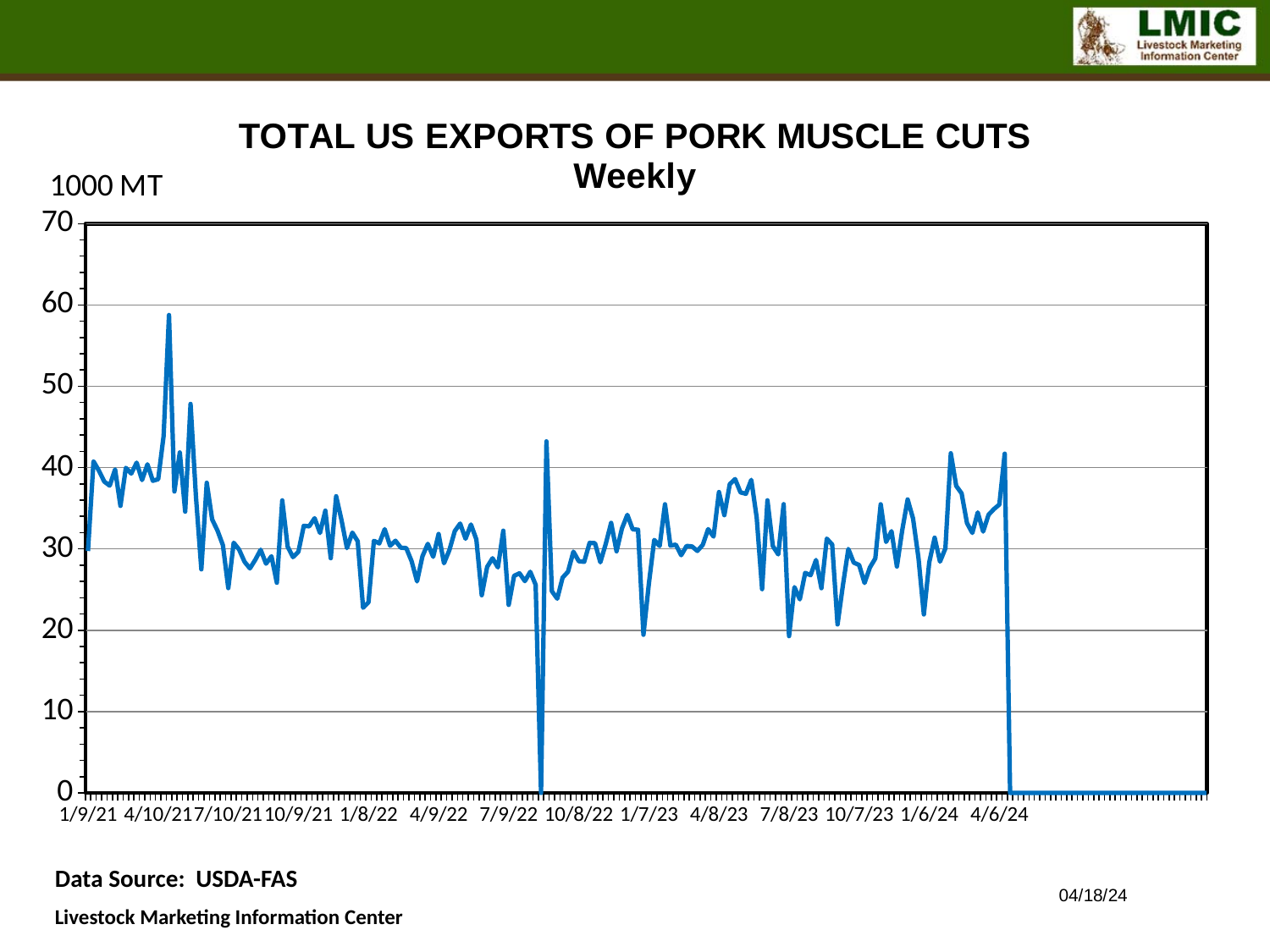
Are the values plotted during 2022 mostly greater or less than 40? less Is the highest value on the chart, the spike in April 2021, greater or less than 50? greater Is the value at the first point on the chart (1/9/21) greater or less than 20? greater How many data series are plotted on the chart? 1 What kind of chart is shown on the slide? line chart What is the title of the chart? TOTAL US EXPORTS OF PORK MUSCLE CUTS Weekly Between the peak in April 2021 and October 2021, does the line generally rise or fall? fall What unit is shown for the y axis of the chart? 1000 MT